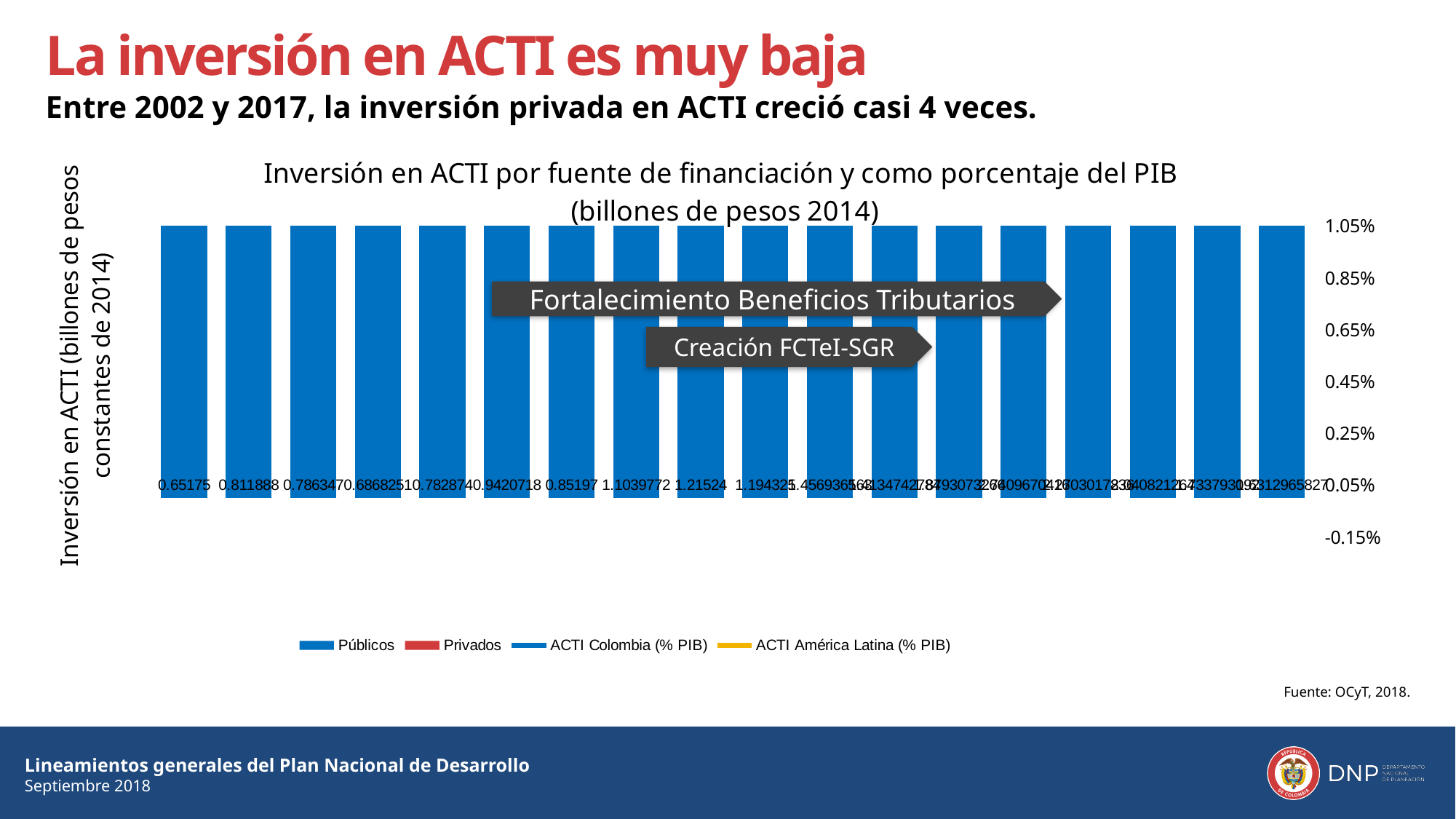
How many series does the chart legend list? 4 What is the title of the chart? Inversión en ACTI por fuente de financiación y como porcentaje del PIB (billones de pesos 2014) Which series in the legend is shown in red? Privados What is the data label on the second bar from the left of the chart? 0.811888 What kind of chart is shown on the slide? bar chart What is the data label on the leftmost bar of the chart? 0.65175